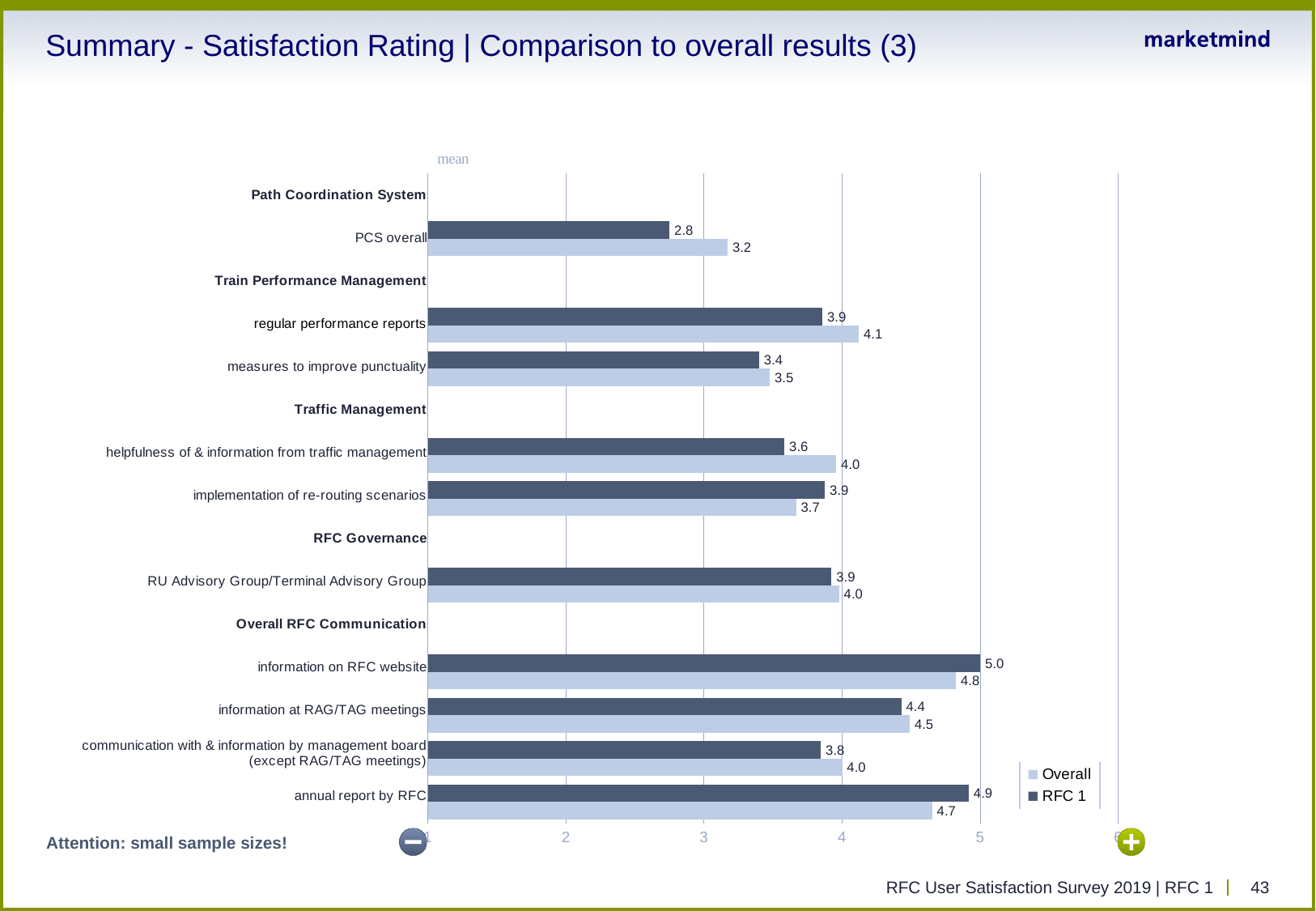
What is the difference between the Overall and RFC 1 values for PCS overall? 0.4 Which item has the lowest Overall value? PCS overall What is the Overall value for information at RAG/TAG meetings? 4.5 What is the RFC 1 value for annual report by RFC? 4.9 Which item has the highest RFC 1 value? information on RFC website Is the RFC 1 value for information on RFC website greater or less than 4? greater For implementation of re-routing scenarios, which is larger: the RFC 1 value or the Overall value? RFC 1 Which series is shown in the darker blue colour? RFC 1 What is the Overall value for helpfulness of & information from traffic management? 4.0 How many series does the legend list? 2 What kind of chart is shown on the slide? bar chart What is the RFC 1 value for PCS overall? 2.8